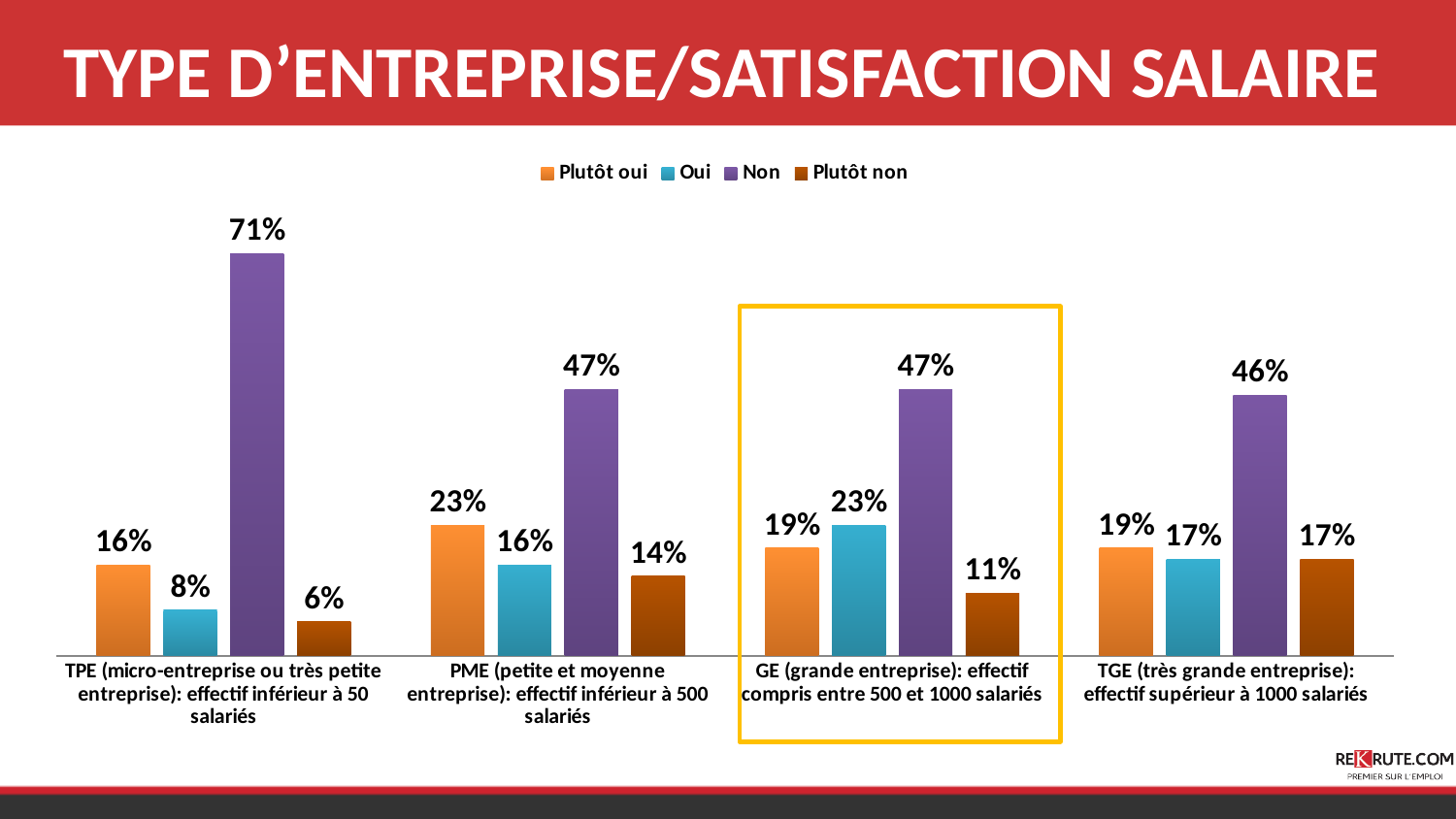
Which company type has the highest "Non" value? TPE (micro-entreprise ou très petite entreprise) Which company type has the lowest "Oui" value? TPE (micro-entreprise ou très petite entreprise) What kind of chart is shown on the slide? Bar chart What is the difference between the "Non" value for TPE and the "Non" value for PME? 24% What is the value of "Plutôt non" for PME (petite et moyenne entreprise)? 14% What is the value of "Plutôt oui" for TGE (très grande entreprise)? 19% How many company types are shown on the x axis? 4 How many series does the legend list? 4 Which is larger: the "Plutôt oui" value for PME or the "Plutôt oui" value for GE? PME Which category is highlighted with a yellow box on the slide? GE (grande entreprise): effectif compris entre 500 et 1000 salariés What is the value of "Oui" for GE (grande entreprise)? 23% What is the value of "Non" for TPE (micro-entreprise ou très petite entreprise)? 71%